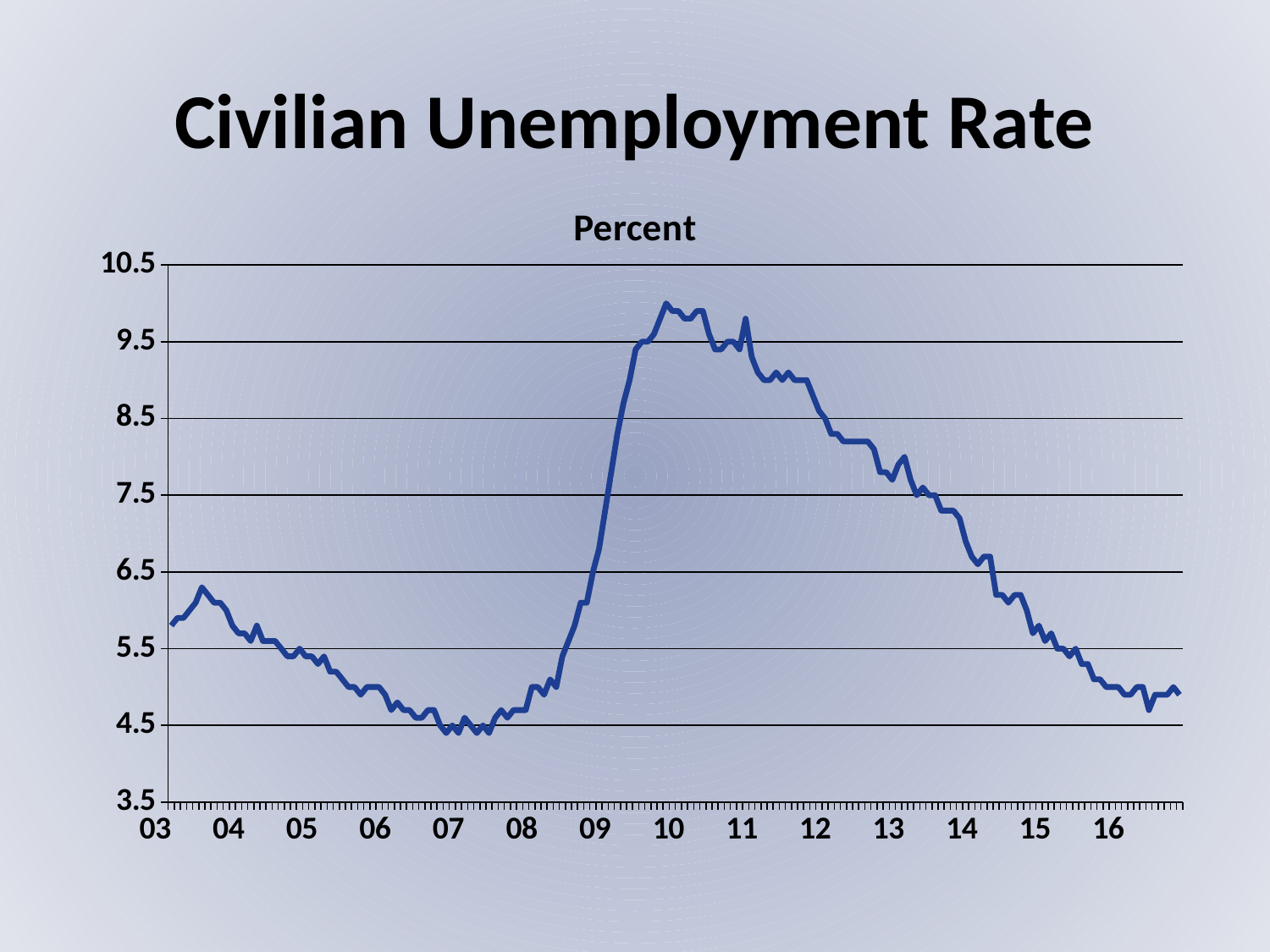
What unit label is shown above the chart's y axis? Percent Does the unemployment rate rise or fall between 2010 and 2016? fall Is the unemployment rate at the start of 2013 greater or less than 7.5? greater Does the unemployment rate rise or fall between the start of 2008 and the start of 2010? rise Is the unemployment rate at the start of 2010 greater or less than 9.5? greater Is the unemployment rate at the start of 2003 greater or less than 5.5? greater How many year labels are shown along the x axis? 14 What kind of chart is shown on the slide? line chart What is the title of the chart? Civilian Unemployment Rate